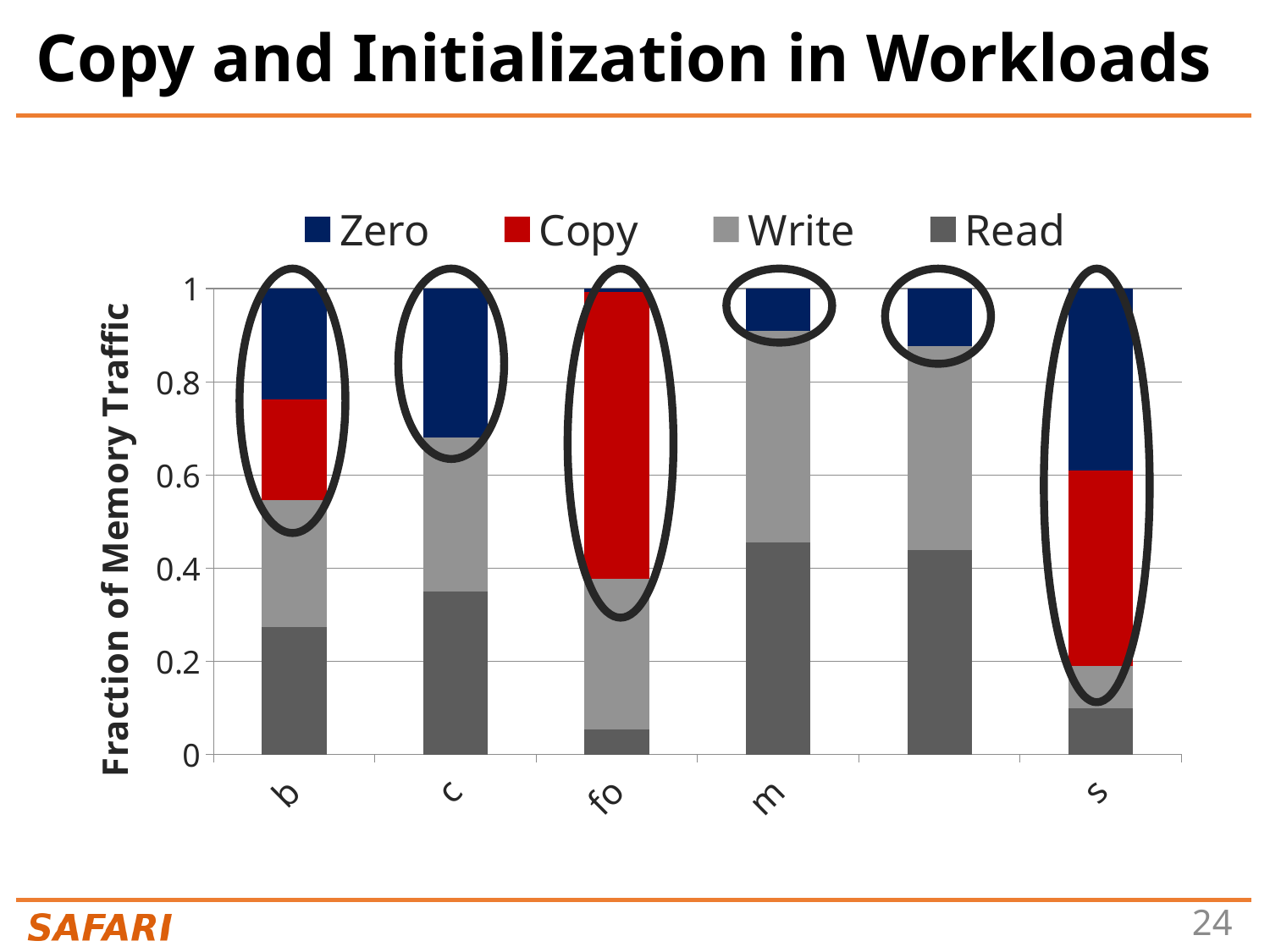
What is the label of the y axis? Fraction of Memory Traffic How many bars are plotted in the chart? 6 Which series is shown in red in the legend? Copy Is the Read value for b greater or less than 0.2? greater Which bar has the largest Copy segment? fo Is the Read value for m greater or less than 0.4? greater How many series does the legend list? 4 Is the Read value for s greater or less than 0.2? less Which is larger, the Read value for m or the Read value for b? m What kind of chart is shown on the slide? Stacked bar chart Which bar has the smallest Read segment? fo